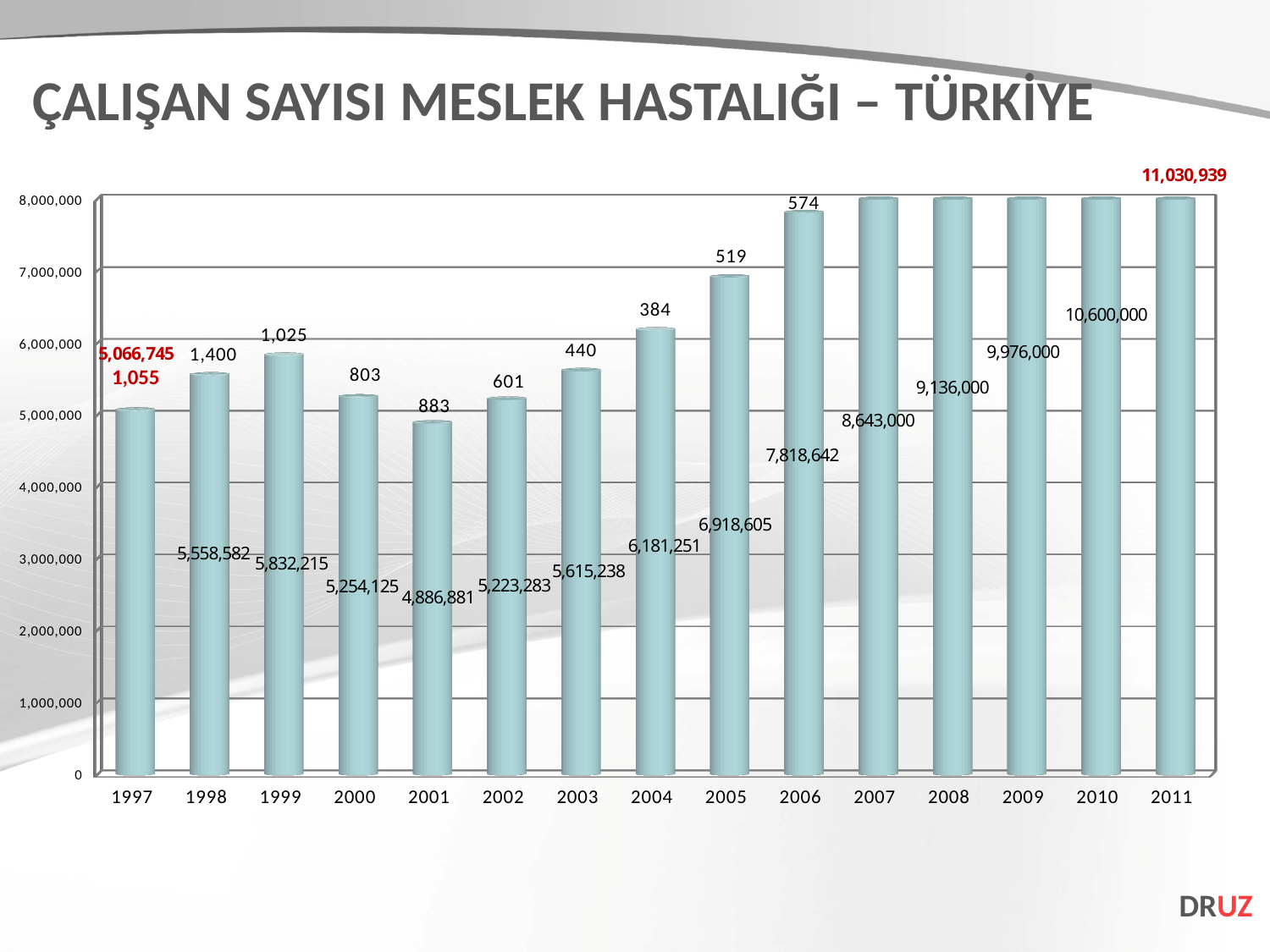
Which year has the lowest occupational disease count (the small number above the bar)? 2004 What is the difference between the number of workers in 2010 and in 2009? 624,000 What is the number of workers shown for 1997? 5,066,745 Which year has the lowest number of workers? 2001 What kind of chart is shown on the slide? bar chart How many years are shown on the x axis? 15 What is the number of workers shown for 2011? 11,030,939 Which year has the highest occupational disease count (the small number above the bar)? 1998 What is the occupational disease count shown above the 1998 bar? 1,400 Do the worker numbers rise or fall from 2004 to 2011? rise What is the number of workers shown for 2004? 6,181,251 Is the number of workers for 2001 greater or less than 5,000,000? less